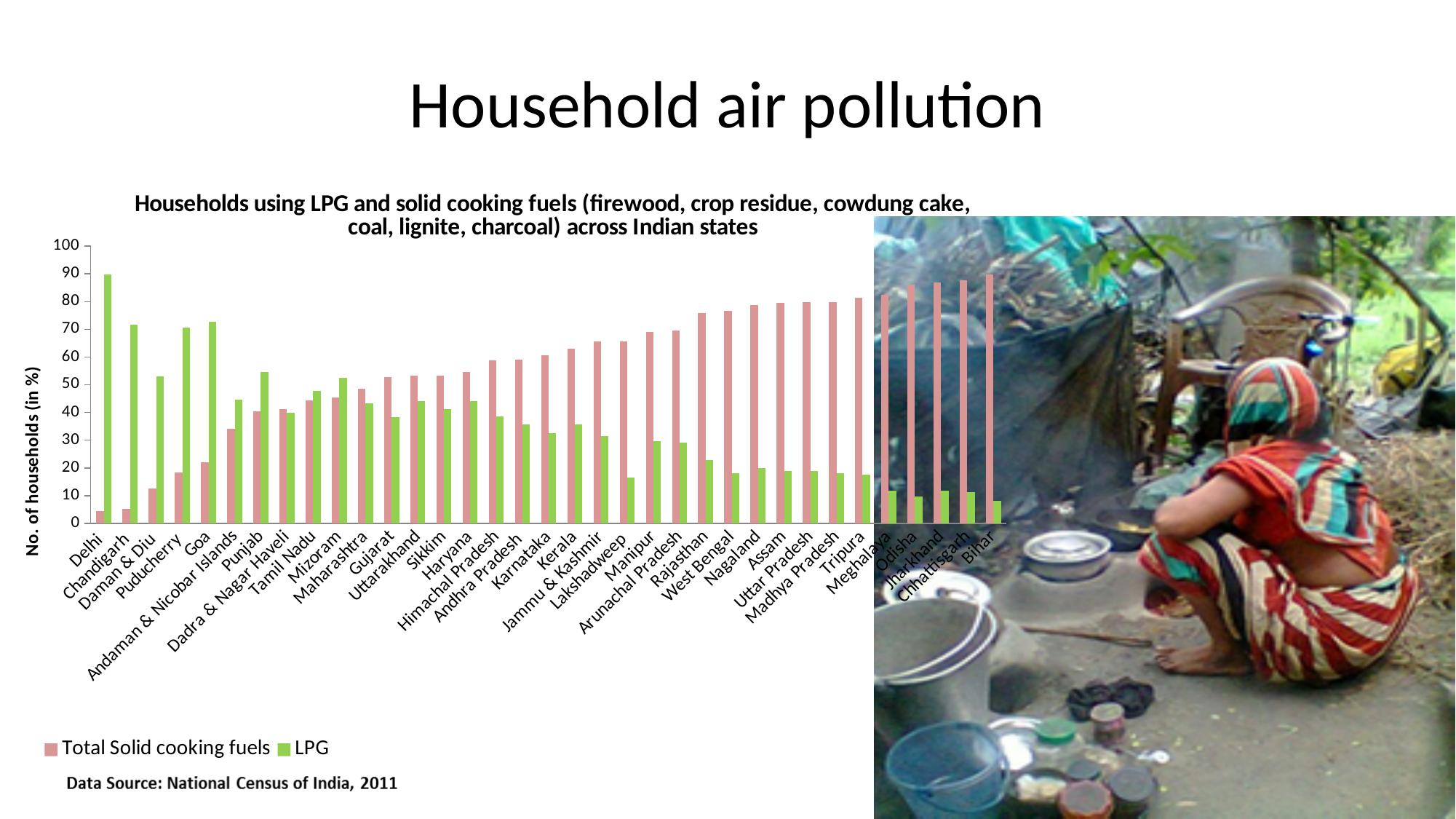
Is the Total Solid cooking fuels value for Bihar greater or less than 80? greater What are the two series listed in the legend? Total Solid cooking fuels and LPG Which is larger for Puducherry: Total Solid cooking fuels or LPG? LPG How many series does the legend list? 2 What kind of chart is shown on the slide? bar chart Is the LPG value for Delhi greater or less than 80? greater Which state has the highest value for Total Solid cooking fuels? Bihar Do the Total Solid cooking fuels values rise or fall moving from left to right along the x axis? rise How many states/union territories are shown on the x axis? 35 Which state has the highest value for LPG? Delhi Is the Total Solid cooking fuels value for Goa greater or less than 30? less